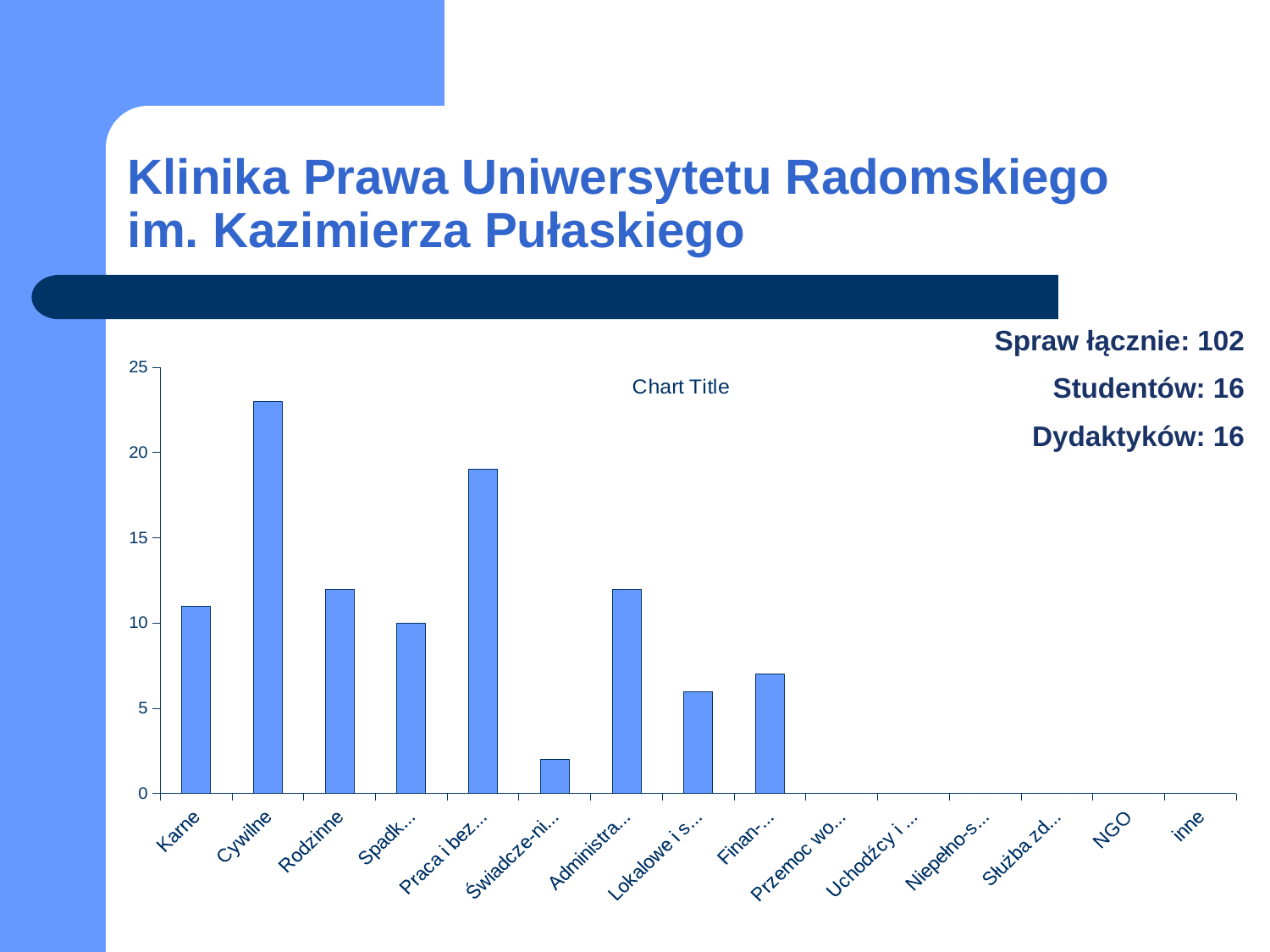
Which category has the tallest bar in the chart? Cywilne Is the value for Praca i bez... greater or less than 15? greater What kind of chart is shown on the slide? bar chart How many categories in the chart have a visible bar above zero? 9 How many categories are listed along the x axis of the chart? 15 Is the value for Cywilne greater or less than 20? greater Is the value for Karne greater or less than 10? greater What title is displayed on the chart? Chart Title Which is larger, the value for Cywilne or the value for Karne? Cywilne Which is larger, the value for Praca i bez... or the value for Rodzinne? Praca i bez...